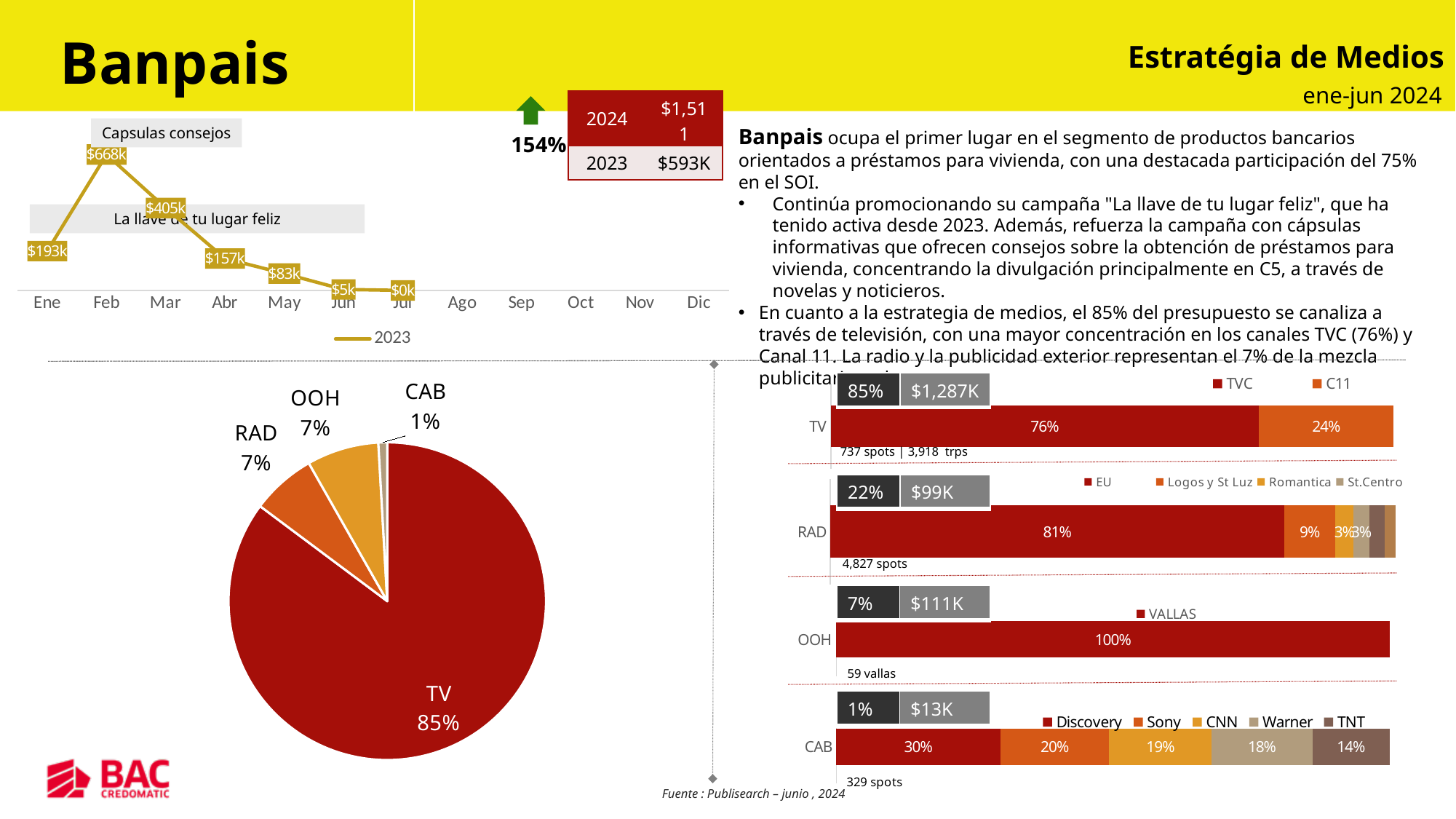
In the pie chart, what share does TV have? 85% In the line chart at the top left, how many series does the legend list? 1 In the line chart at the top left, what is the difference between the values for Feb and Mar? $263k In the line chart at the top left, what is the value for Feb? $668k In the CAB stacked bar on the right, which channel has the largest share? Discovery In the line chart at the top left, which month has the highest value? Feb In the CAB stacked bar on the right, how many series does the legend list? 5 How many slices does the pie chart have? 4 In the TV stacked bar on the right, what is the value for TVC? 76% In the line chart at the top left, do the values rise or fall from Feb to Jul? fall In the RAD stacked bar on the right, what is the value for EU? 81% In the pie chart, which category has the smallest slice? CAB